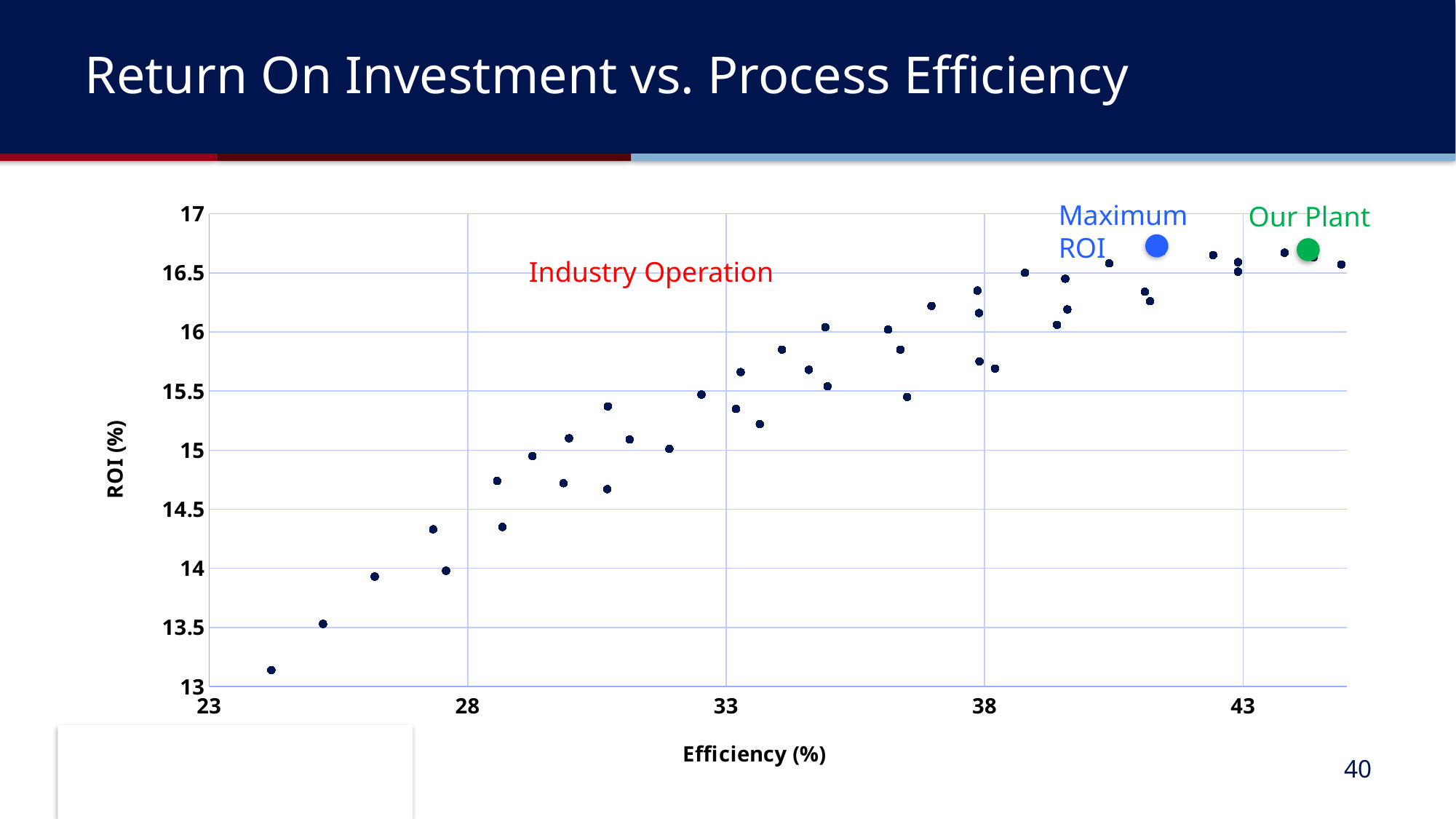
How many labelled series are shown on the chart? 3 Which series has the lowest ROI values on the chart? Industry Operation What kind of chart is shown on the slide? Scatter chart Is the ROI value for the Maximum ROI point greater or less than 16.5? greater What is the title of the chart on the slide? Return On Investment vs. Process Efficiency Which has the higher efficiency value, Our Plant or the Maximum ROI point? Our Plant Is the efficiency value for Our Plant greater or less than 43? greater Is the ROI of the lowest Industry Operation point greater or less than 13.5? less What is the label of the vertical axis? ROI (%) As efficiency increases along the x axis, does ROI generally rise or fall? Rise